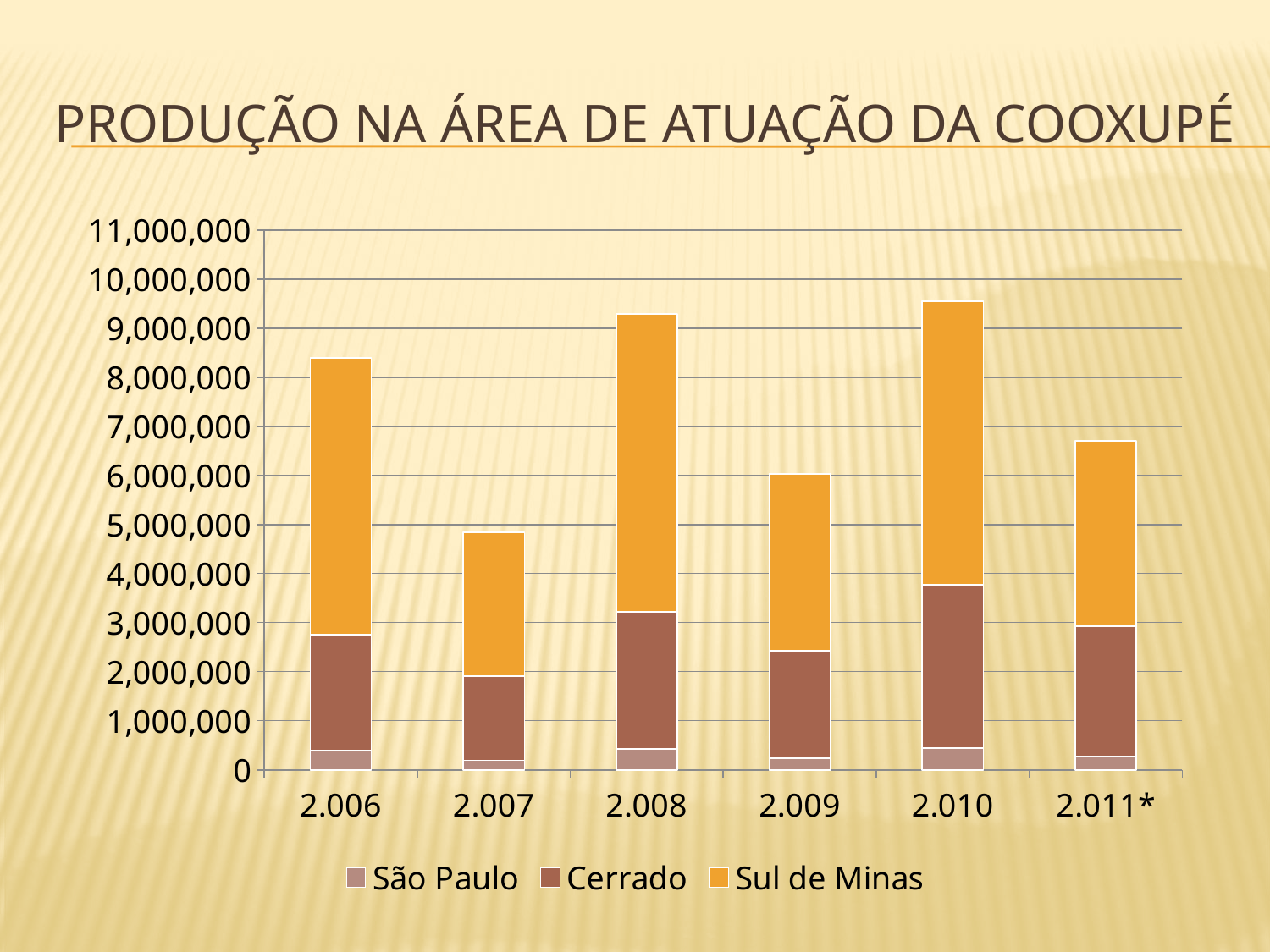
How many years are shown on the x axis of the chart? 6 What is the title of the chart on the slide? PRODUÇÃO NA ÁREA DE ATUAÇÃO DA COOXUPÉ Is the total production for 2.008 greater or less than 9,000,000? greater Which year has the lowest total production in the chart? 2.007 Is the total production for 2.009 greater or less than 5,000,000? greater How many series does the chart's legend list? 3 Is the total production for 2.010 greater or less than 10,000,000? less Which year has a larger total production, 2.009 or 2.011*? 2.011* Which series is shown in the top (orange) segment of each stacked bar? Sul de Minas Which year has the highest total production in the chart? 2.010 What kind of chart is shown on the slide? Stacked bar chart